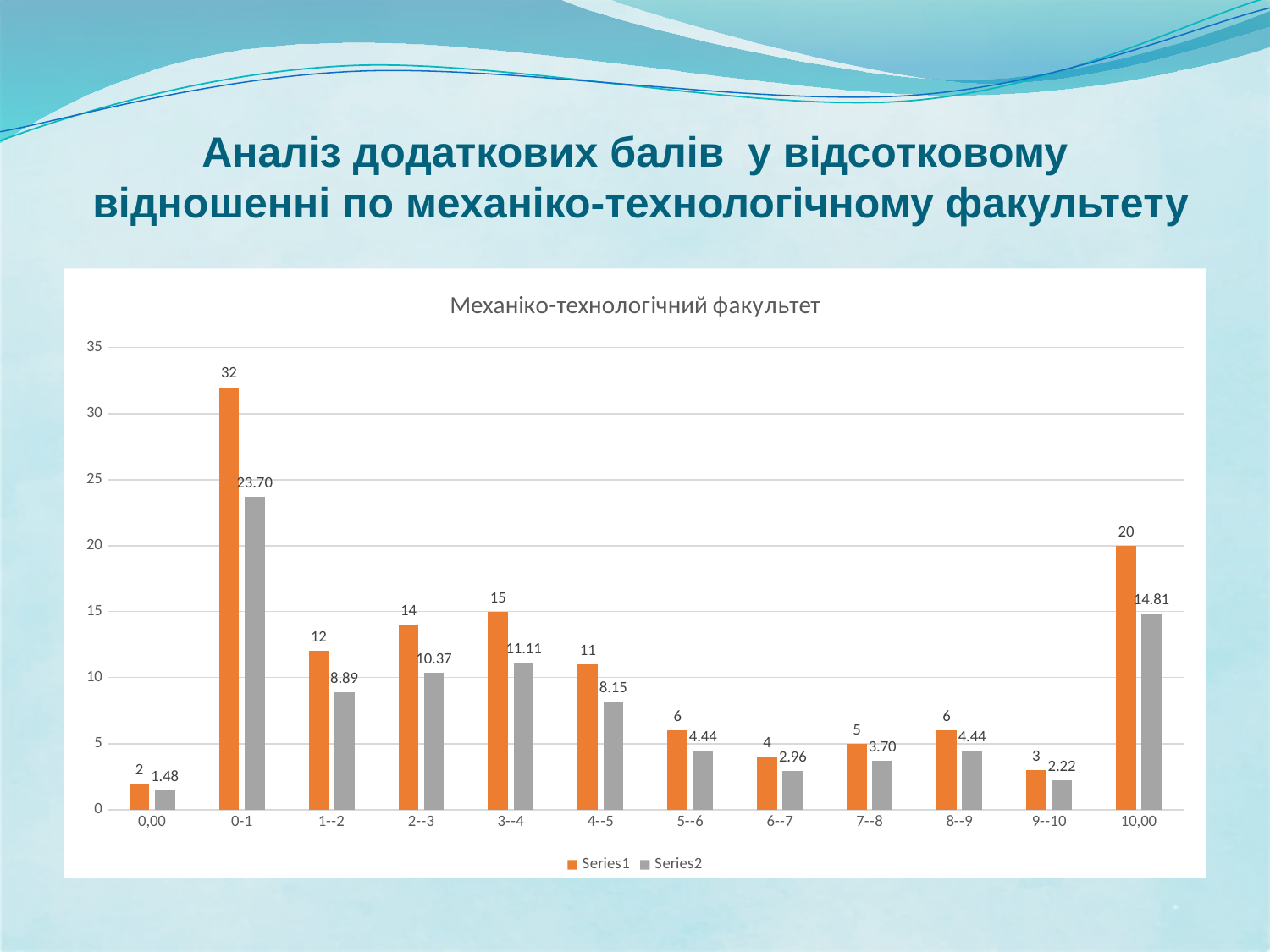
What is the Series2 value for the category 6--7? 2.96 What is the Series2 value for the category 3--4? 11.11 Which category has the lowest Series2 value? 0,00 What is the Series2 value for the category 10,00? 14.81 What is the difference between the Series1 values for 0-1 and 10,00? 12 What kind of chart is shown on the slide? bar chart Which is larger: the Series1 value for 2--3 or the Series1 value for 4--5? 2--3 What is the title of the chart? Механіко-технологічний факультет What is the Series1 value for the category 0-1? 32 How many series does the legend list? 2 Which category has the highest Series1 value? 0-1 How many categories are shown on the x axis? 12